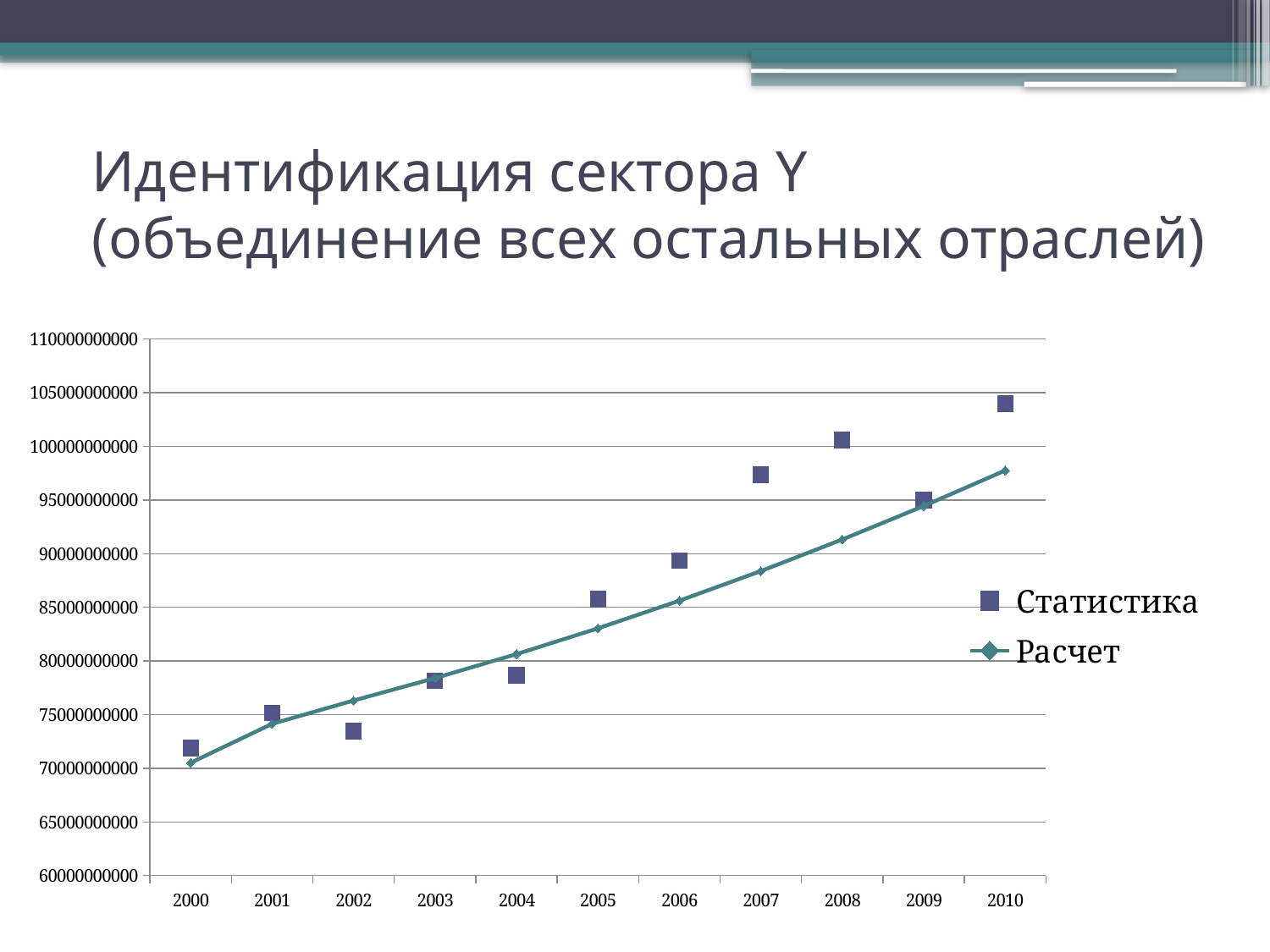
Does the Расчет series rise or fall from 2000 to 2010? rise In 2004, which series has the larger value, Статистика or Расчет? Расчет Is the Статистика value for 2002 greater or less than 75000000000? less What are the two series named in the legend? Статистика and Расчет In which year is the Статистика value highest? 2010 Is the Расчет value for 2010 greater or less than 100000000000? less How many years are shown on the x axis? 11 Is the Статистика value for 2010 greater or less than 100000000000? greater In 2008, which series has the larger value, Статистика or Расчет? Статистика How many series does the legend list? 2 In which year is the Статистика value lowest? 2000 What kind of chart is shown on the slide? line chart